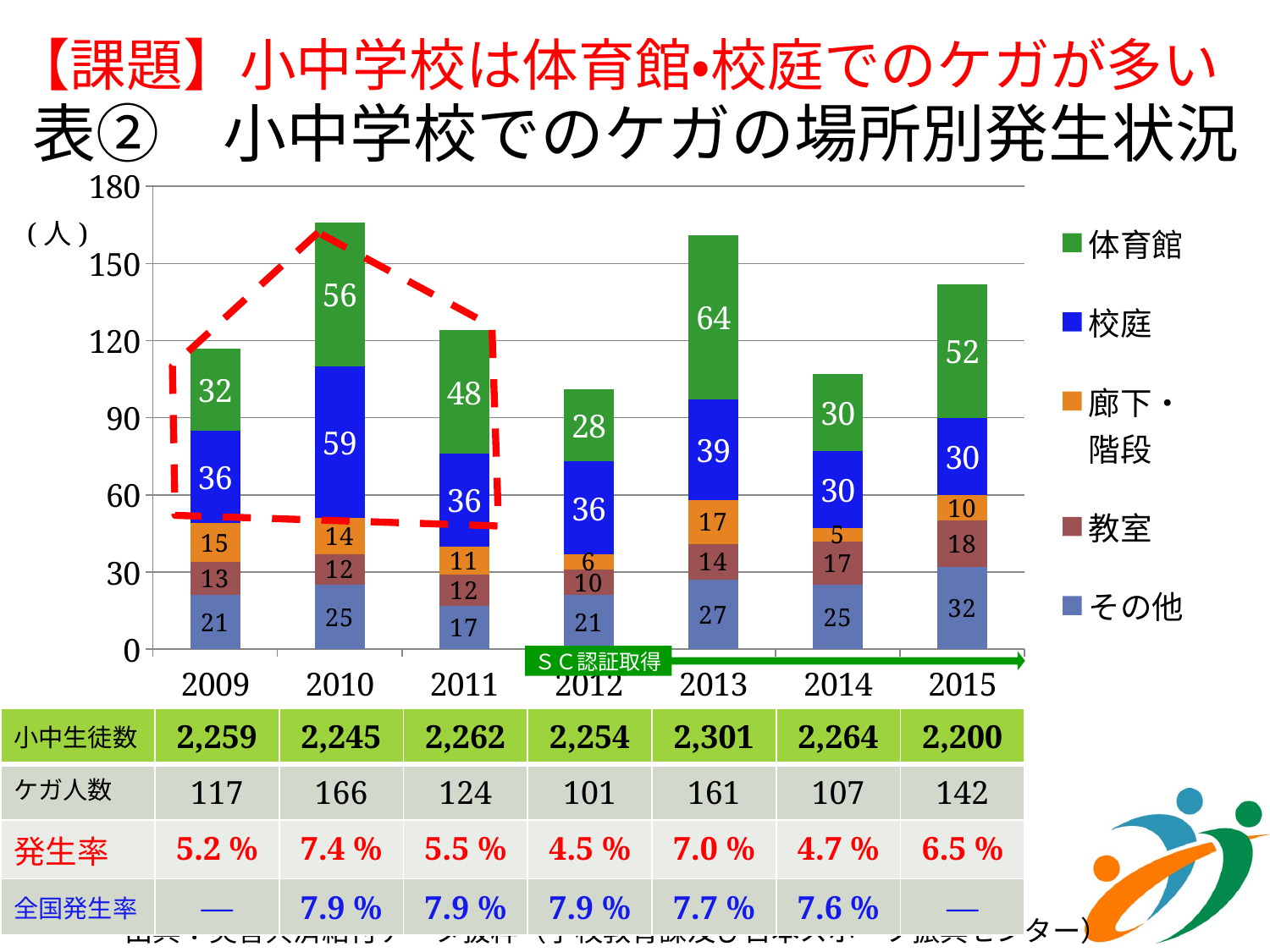
In which year is the 教室 value lowest? 2012 How many series does the legend list? 5 What is the difference between the 校庭 values for 2010 and 2009? 23 What is the value for 体育館 in 2013? 64 What is the value for 校庭 in 2010? 59 What type of chart is shown on the slide? Stacked bar chart Which is larger, the 体育館 value in 2011 or the 体育館 value in 2012? 2011 What is the value for 廊下・階段 in 2014? 5 In which year is the 体育館 value highest? 2013 What is the total of the stacked bar for 2010? 166 What is the value for その他 in 2015? 32 How many years (categories) are shown on the x axis of the chart? 7